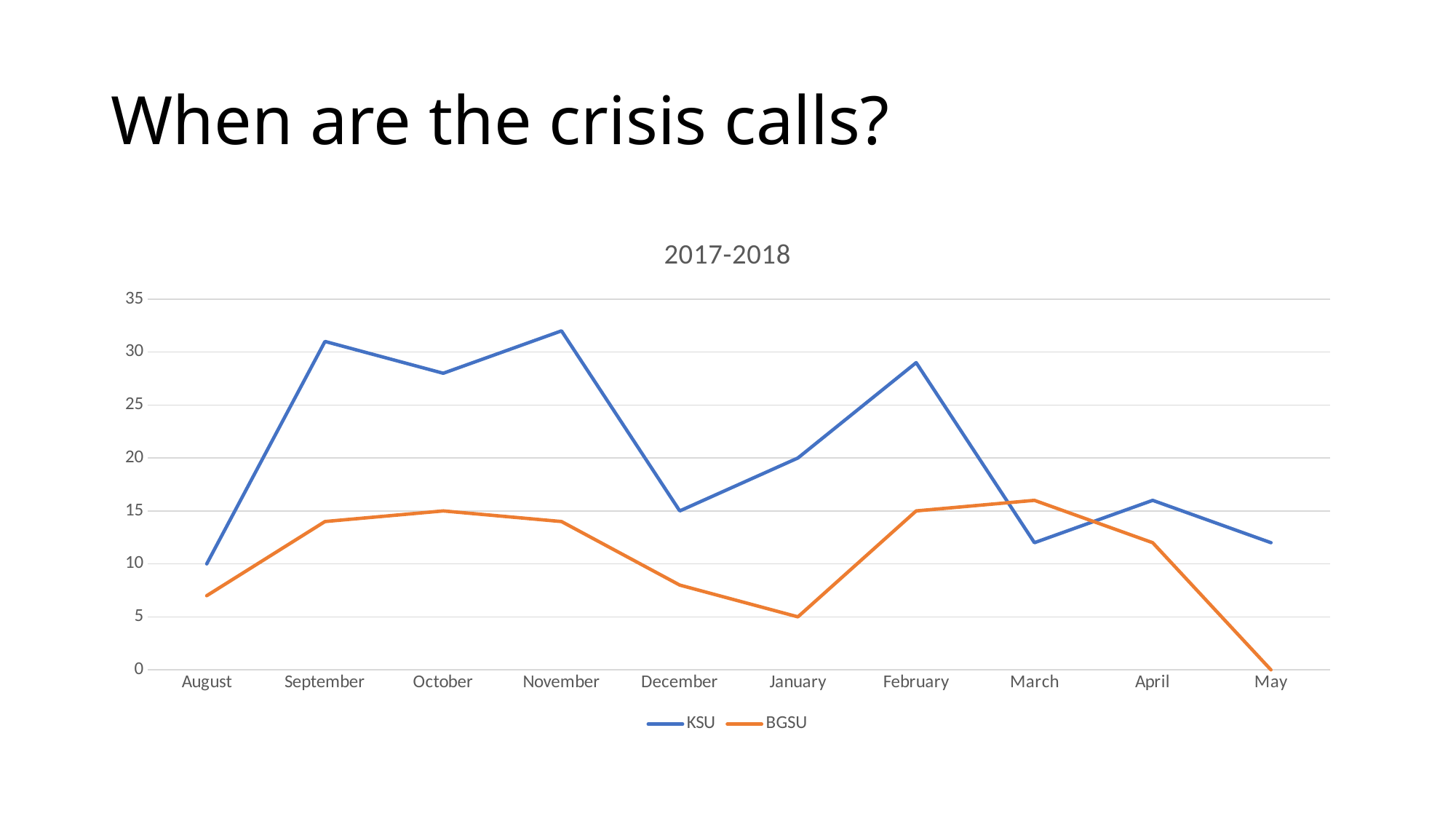
What type of chart is shown on the slide? line chart What is the KSU value for December? 15 Is the KSU value for September greater or less than 30? greater Does the BGSU line rise or fall from April to May? fall Which series has the larger value in March, KSU or BGSU? BGSU How many series does the legend list? 2 What is the title of the chart? 2017-2018 In which month is the BGSU line at its lowest? May In which month is the KSU line at its highest? November How many months are shown on the x axis? 10 What is the BGSU value for May? 0 What is the KSU value for August? 10